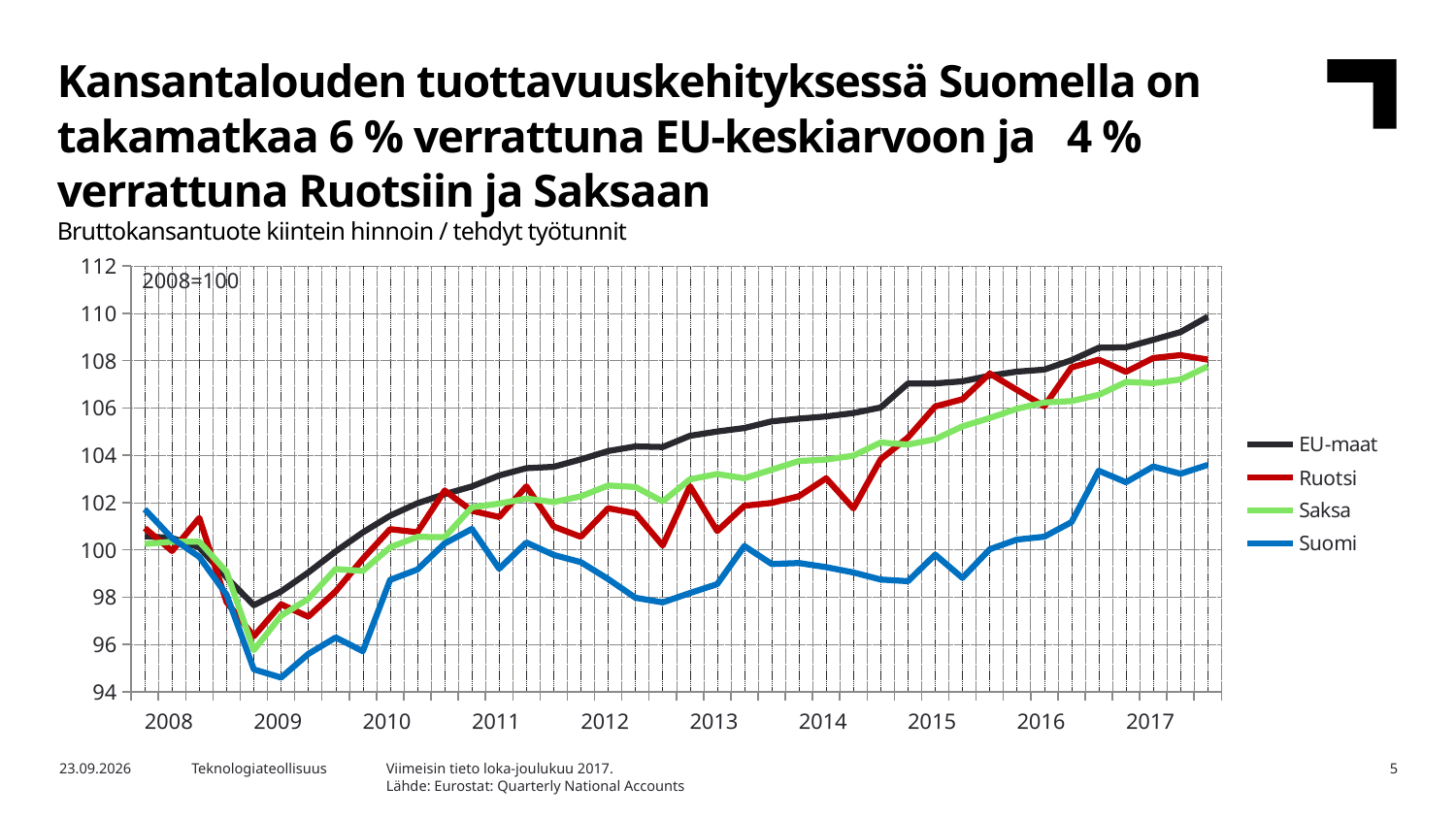
Which series has the highest value at the end of 2017? EU-maat Which series are listed in the chart legend? EU-maat, Ruotsi, Saksa, Suomi At the end of 2017, is the value for EU-maat greater or less than 108? greater At the end of 2017, is the value for Suomi greater or less than 102? greater At the end of 2017, is the value for Saksa greater or less than 106? greater How many series does the chart legend list? 4 Which series has the lowest value at the end of 2017? Suomi At the end of 2017, which is larger: the value for EU-maat or the value for Suomi? EU-maat Does the EU-maat series rise or fall from 2010 to 2017? rise What kind of chart is shown on the slide? line chart What base year and index value does the chart state? 2008=100